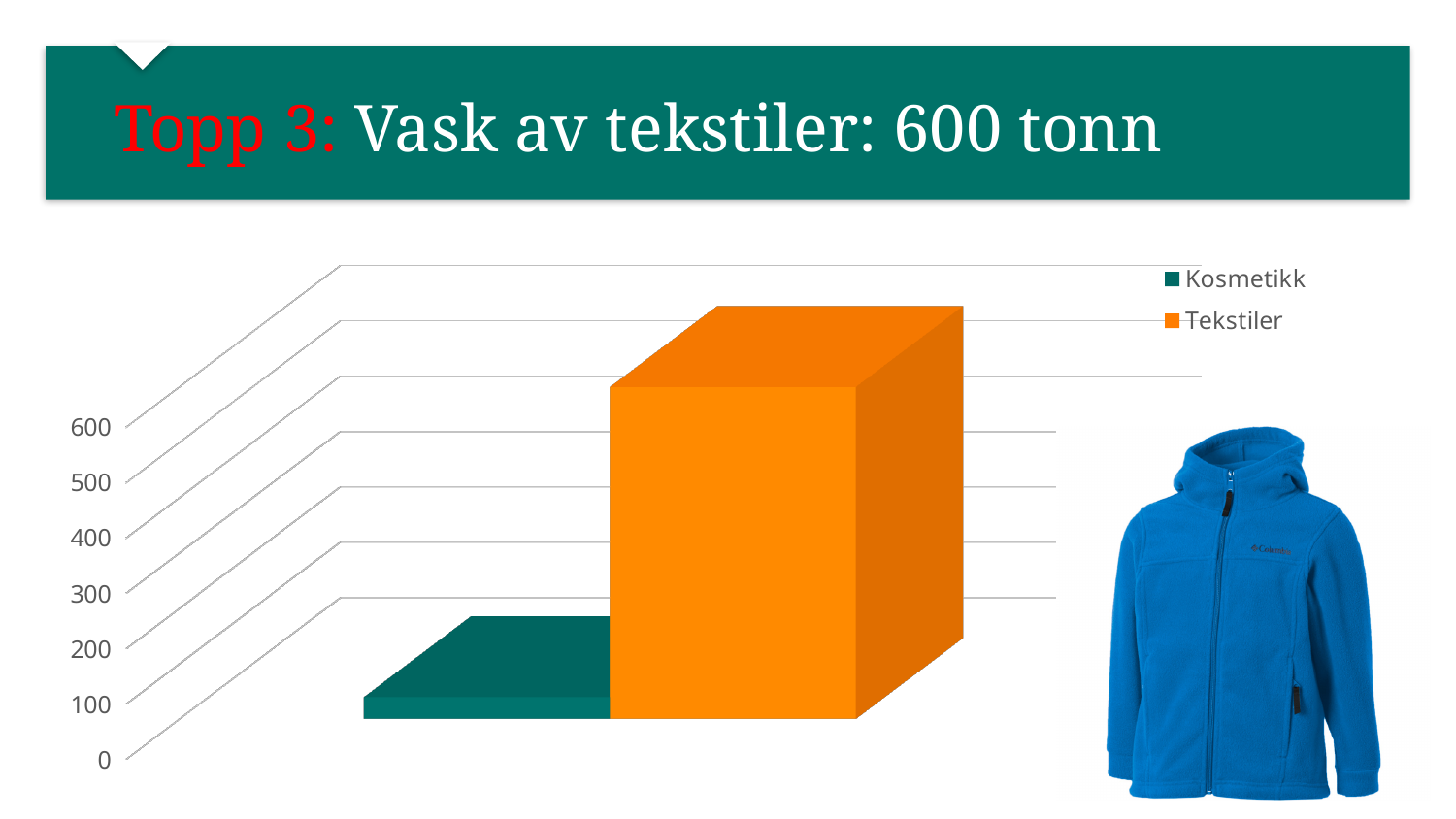
What is the highest value shown on the vertical axis? 600 What colour is the bar for Tekstiler? orange How many series does the legend list? 2 Is the value for Tekstiler greater or less than 400? greater Which series has the lowest bar? Kosmetikk Is the value for Kosmetikk greater or less than 200? less What are the two series named in the legend? Kosmetikk and Tekstiler What kind of chart is shown on the slide? bar chart Which series has the highest bar? Tekstiler Is the value for Tekstiler greater or less than 300? greater Which is larger, the value for Kosmetikk or the value for Tekstiler? Tekstiler